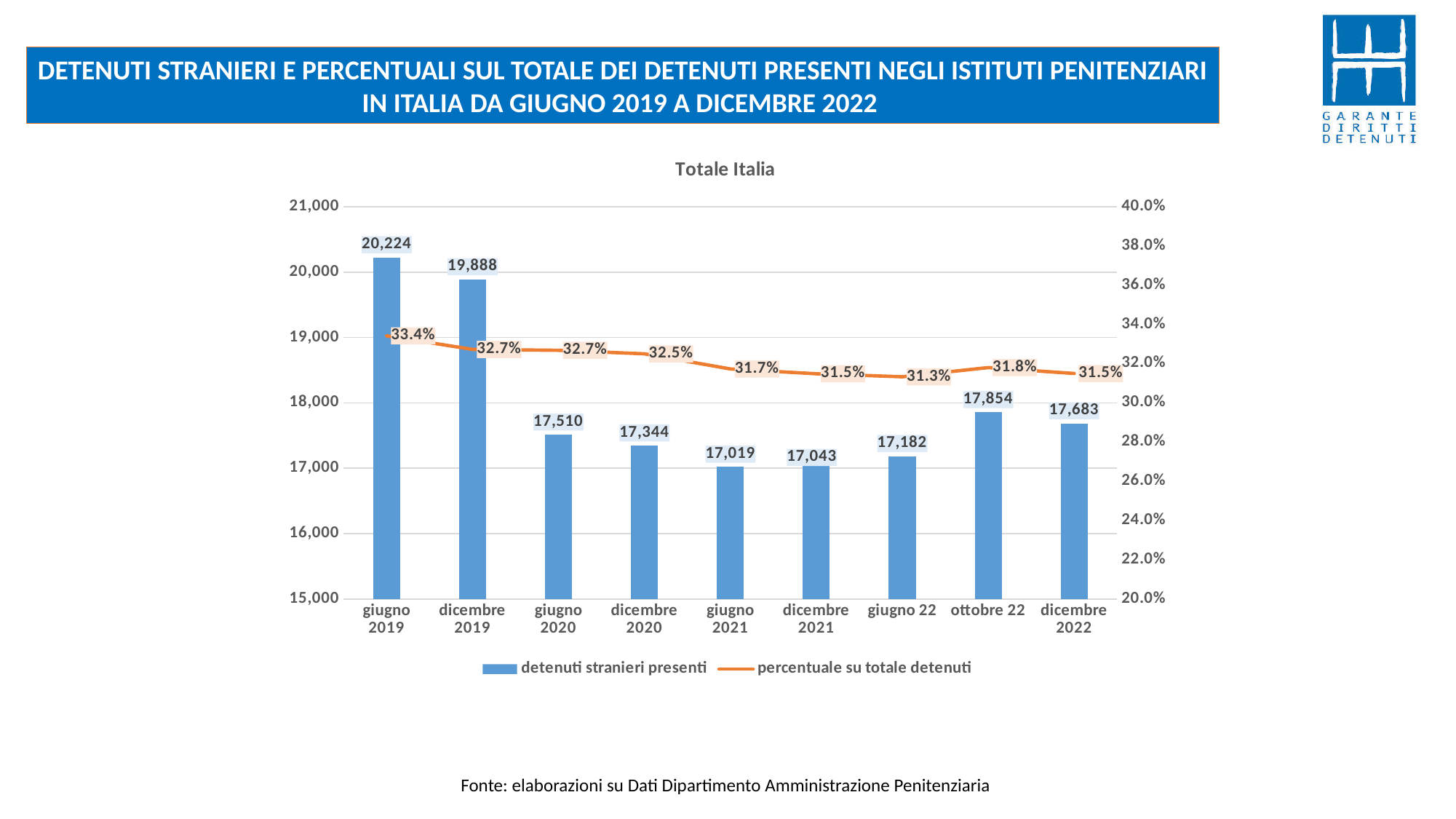
How many periods are shown on the x axis? 9 What is the value of 'detenuti stranieri presenti' for giugno 2019? 20,224 What is the value of 'detenuti stranieri presenti' for ottobre 22? 17,854 What is the 'percentuale su totale detenuti' for dicembre 2022? 31.5% Which period has the highest number of 'detenuti stranieri presenti'? giugno 2019 Which is larger, the number of 'detenuti stranieri presenti' in dicembre 2020 or in giugno 22? dicembre 2020 What kind of chart is used for the 'detenuti stranieri presenti' series? bar chart How many series does the legend list? 2 What is the title of the chart? Totale Italia Which period has the lowest 'percentuale su totale detenuti'? giugno 22 Which period has the lowest number of 'detenuti stranieri presenti'? giugno 2021 What is the difference in 'detenuti stranieri presenti' between giugno 2019 and dicembre 2022? 2,541